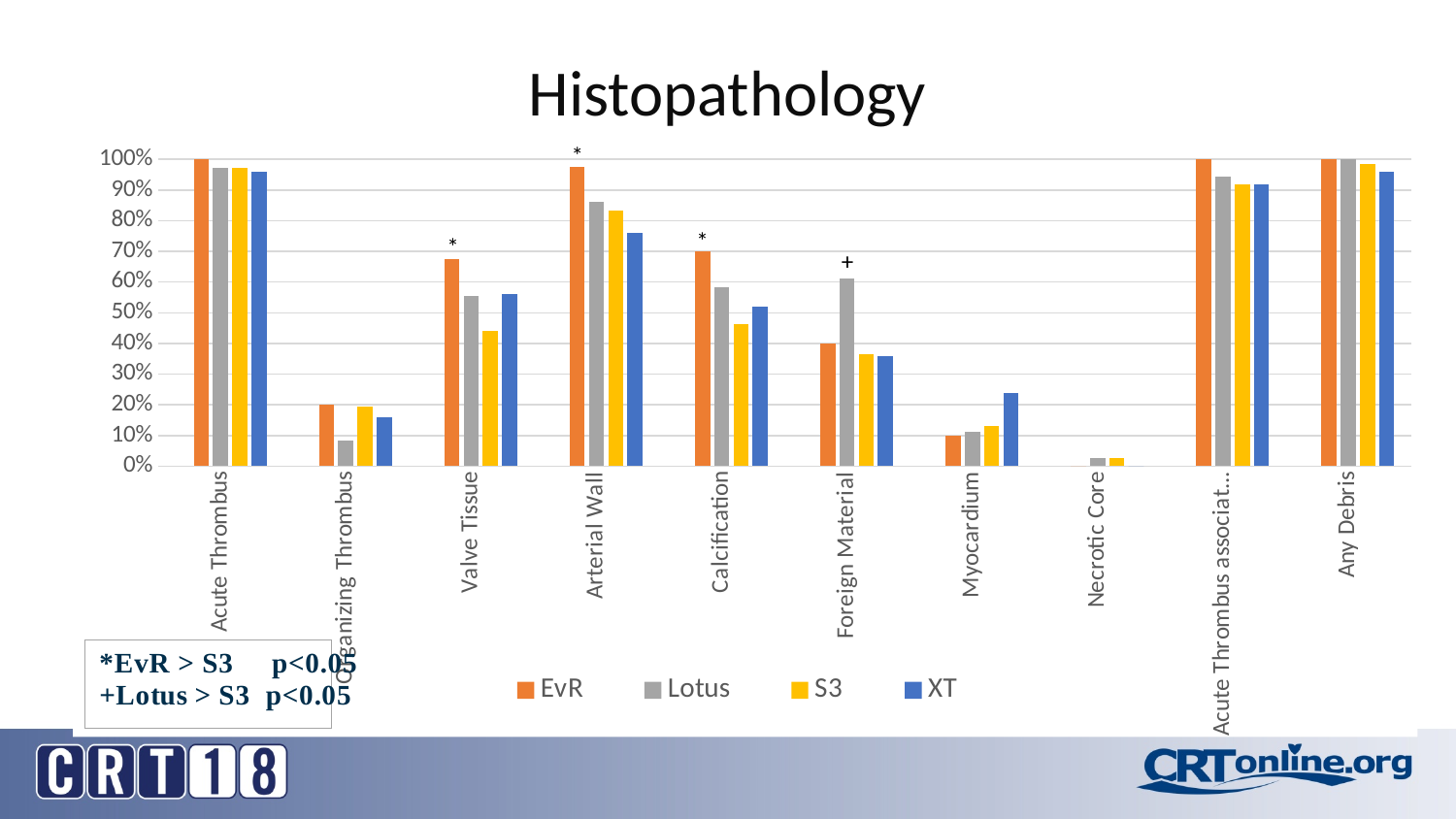
In the Arterial Wall category, which is larger: the value for EvR or the value for XT? EvR What is the value for EvR in the Any Debris category? 100% Is the value for Lotus in the Foreign Material category greater or less than 50%? greater Which series has the highest value in the Valve Tissue category? EvR How many categories are shown along the x axis? 10 What is the value for EvR in the Acute Thrombus category? 100% Is the value for EvR in the Valve Tissue category greater or less than 60%? greater Is the value for S3 in the Calcification category greater or less than 50%? less How many series does the legend list? 4 What kind of chart is shown on the slide? bar chart What is the title of the chart? Histopathology In the Foreign Material category, which is larger: the value for Lotus or the value for EvR? Lotus